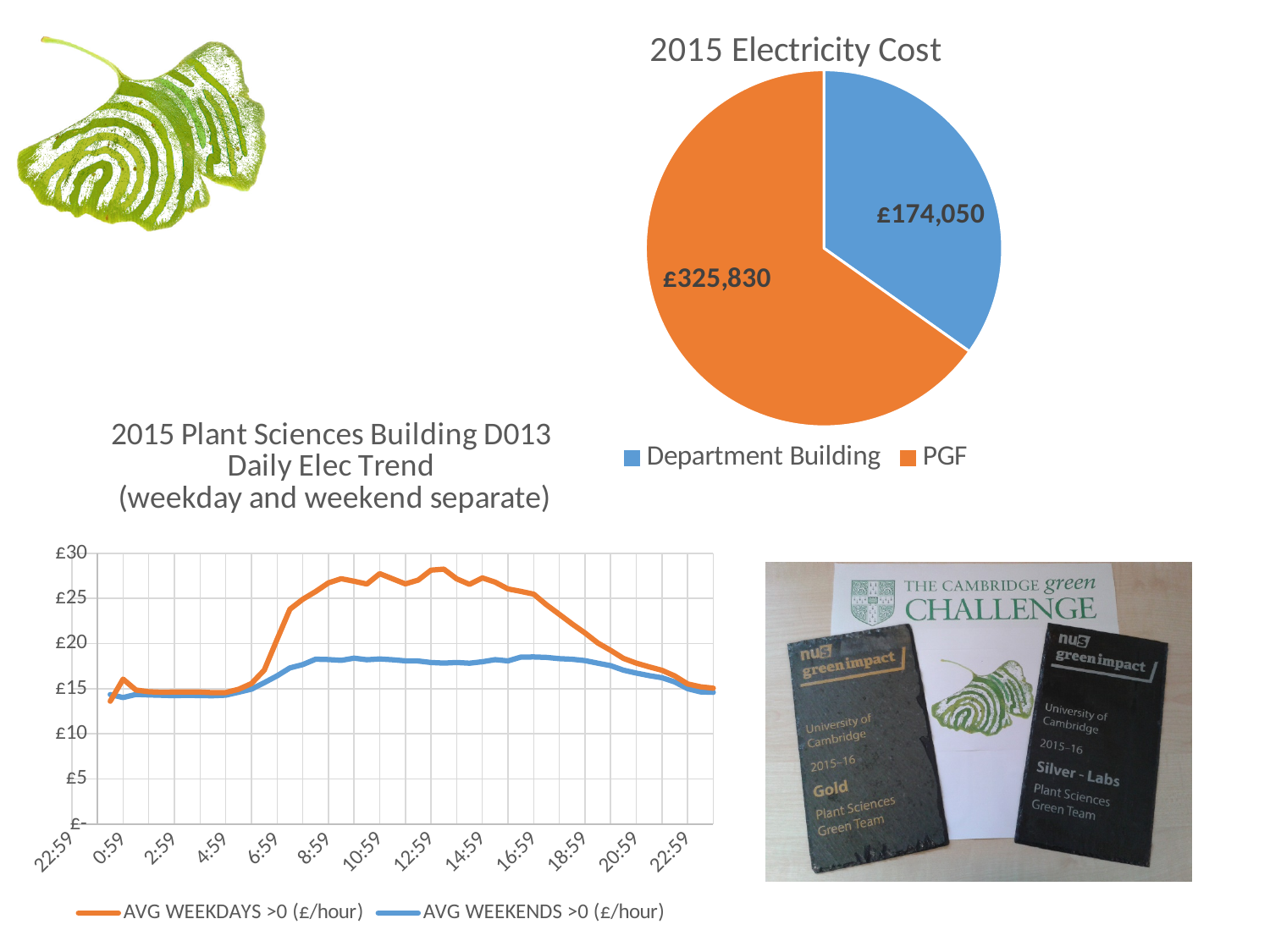
What type of chart is the 2015 Plant Sciences Building D013 Daily Elec Trend chart? Line chart What type of chart is the 2015 Electricity Cost chart? Pie chart In the 2015 Electricity Cost pie chart, what is the value for PGF? £325,830 In the 2015 Electricity Cost pie chart, what is the total of the two slices? £499,880 In the 2015 Electricity Cost pie chart, what is the difference between the PGF and Department Building values? £151,780 In the 2015 Electricity Cost pie chart, which category has the larger value? PGF In the 2015 Electricity Cost pie chart, what is the value for Department Building? £174,050 In the 2015 Electricity Cost chart, how many categories does the legend list? 2 In the 2015 Plant Sciences Building D013 Daily Elec Trend chart, is the AVG WEEKDAYS value at 12:59 greater or less than £25? greater In the 2015 Plant Sciences Building D013 Daily Elec Trend chart, which series is higher at 10:59, AVG WEEKDAYS or AVG WEEKENDS? AVG WEEKDAYS >0 (£/hour) In the 2015 Plant Sciences Building D013 Daily Elec Trend chart, how many series does the legend list? 2